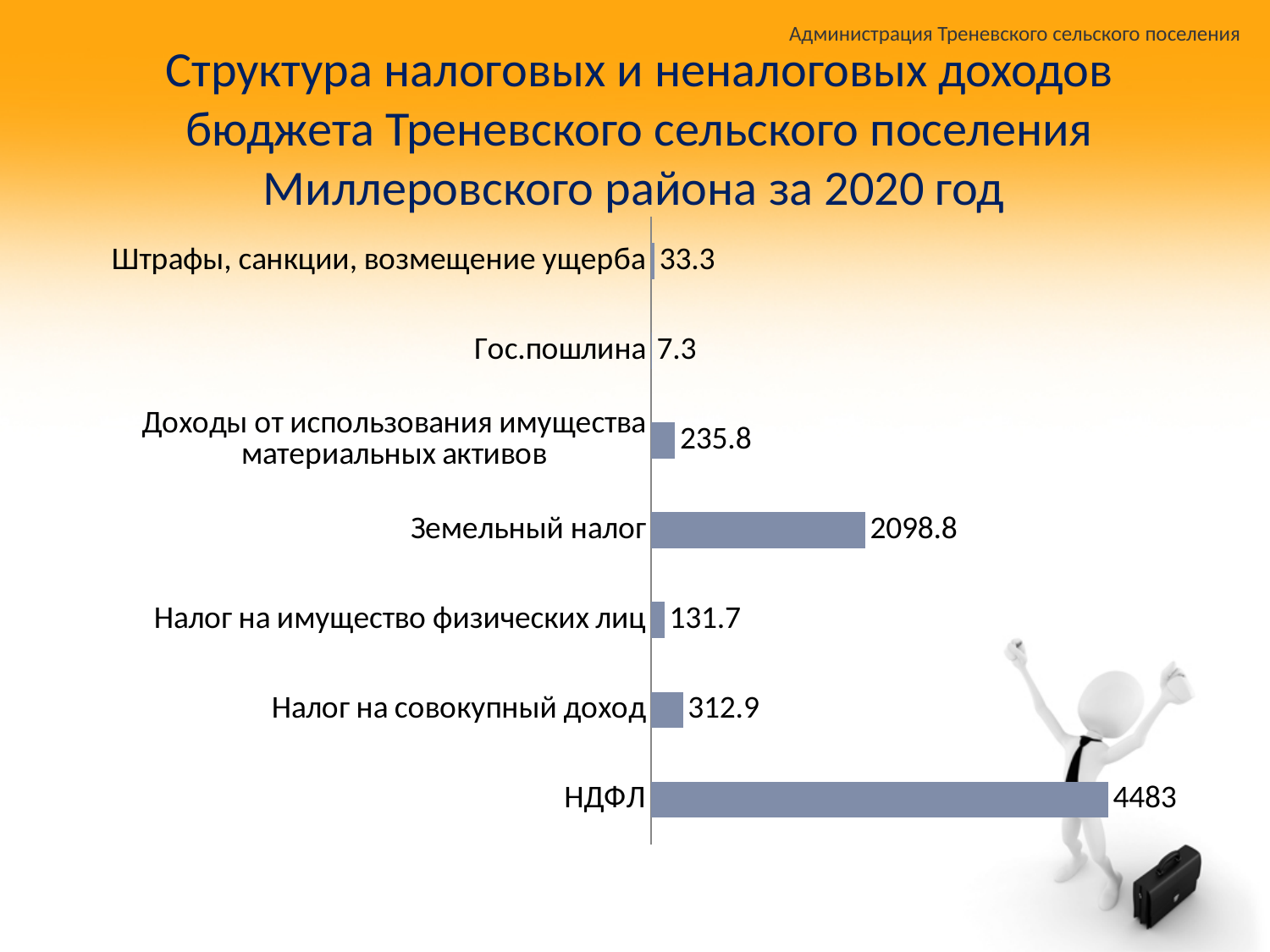
Which is larger, the value for Налог на совокупный доход or the value for Налог на имущество физических лиц? Налог на совокупный доход What is the value for Земельный налог? 2098.8 Which category has the highest value? НДФЛ What is the value for Гос.пошлина? 7.3 What is the value for Налог на совокупный доход? 312.9 What is the value for НДФЛ? 4483 How many categories are shown in the chart? 7 What is the difference between the values for НДФЛ and Земельный налог? 2384.2 Which is larger, the value for Доходы от использования имущества материальных активов or the value for Штрафы, санкции, возмещение ущерба? Доходы от использования имущества материальных активов What kind of chart is shown on the slide? Bar chart What is the difference between the values for Налог на совокупный доход and Налог на имущество физических лиц? 181.2 Which category has the lowest value? Гос.пошлина